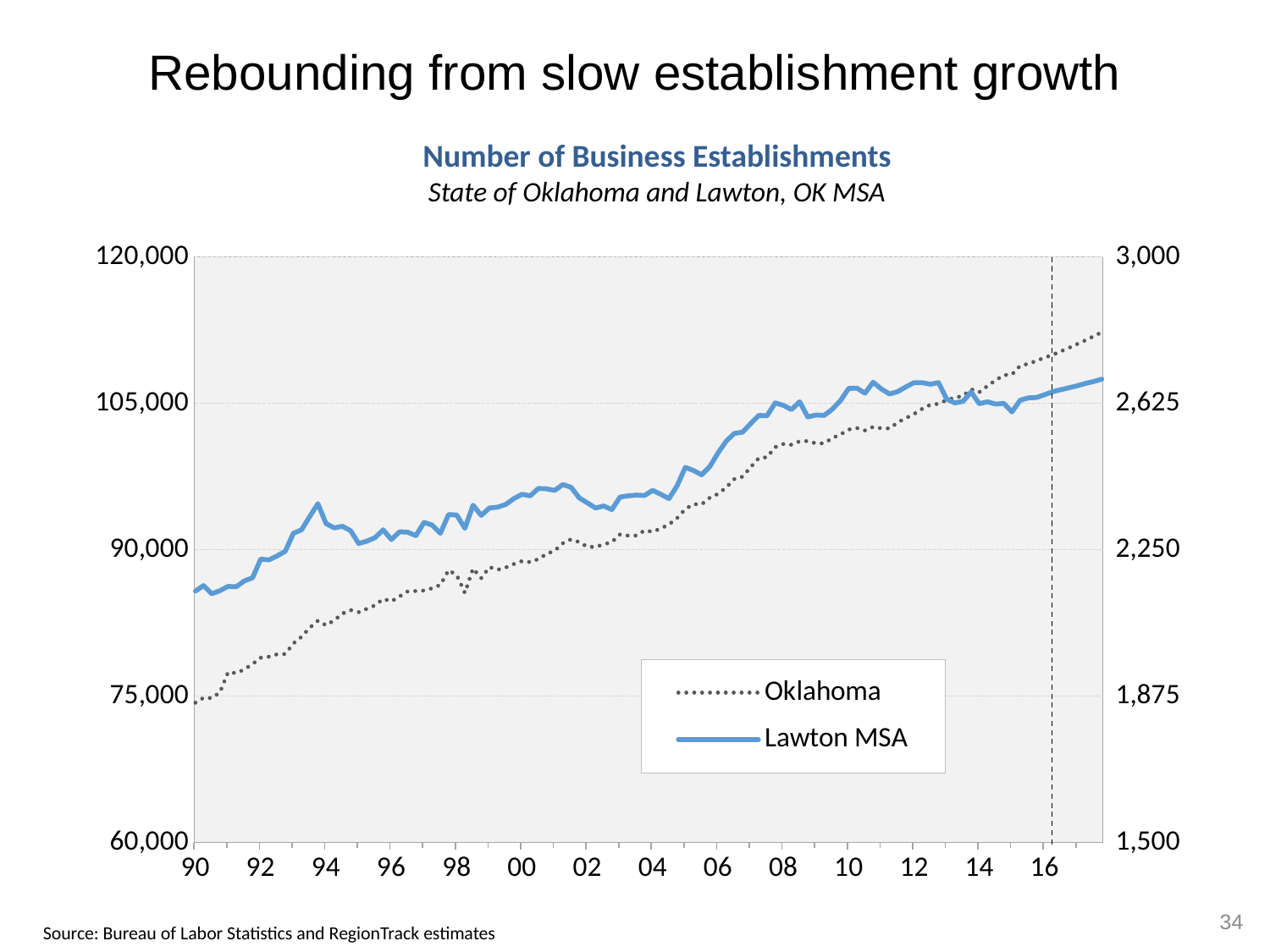
Reading the Lawton MSA line against the right axis, is its value at 12 greater or less than 2,625? greater What is the highest value shown on the left vertical axis? 120,000 Reading the Oklahoma line against the left axis, is its value at 16 greater or less than 105,000? greater Reading the Oklahoma line against the left axis, is its value at 06 greater or less than 105,000? less Does the Oklahoma line generally rise or fall from 90 to the end of the x axis? rise What kind of chart is shown on the slide? line chart What is the title of the chart? Number of Business Establishments Does the Lawton MSA line generally rise or fall from 90 to the end of the x axis? rise What are the two series named in the legend? Oklahoma and Lawton MSA How many series does the legend list? 2